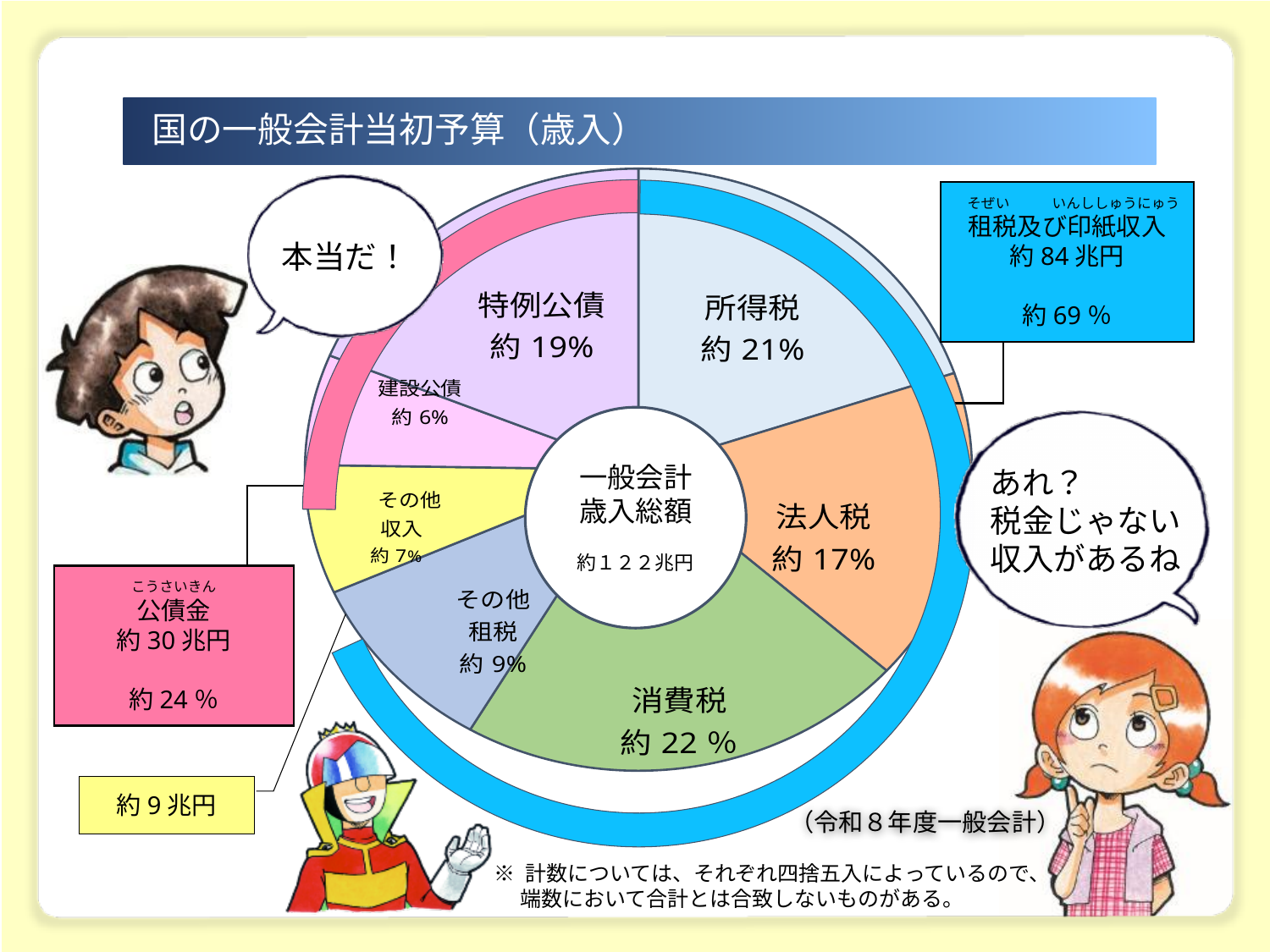
What share of the pie is labelled for 消費税? 約 22% What kind of chart is shown on the slide? pie chart Which slice of the pie has the smallest share? 建設公債 How many slices does the pie chart have? 7 What total amount is shown in the centre of the pie for 一般会計歳入総額? 約１２２兆円 What share of the pie is labelled for 所得税? 約 21% What share of the pie is labelled for 法人税? 約 17% What share of the pie is labelled for 建設公債? 約 6% Which is larger, the share for 特例公債 or the share for 法人税? 特例公債 What share of the pie is labelled for 特例公債? 約 19% What is the title of the chart on the slide? 国の一般会計当初予算（歳入） Which slice of the pie has the largest share? 消費税